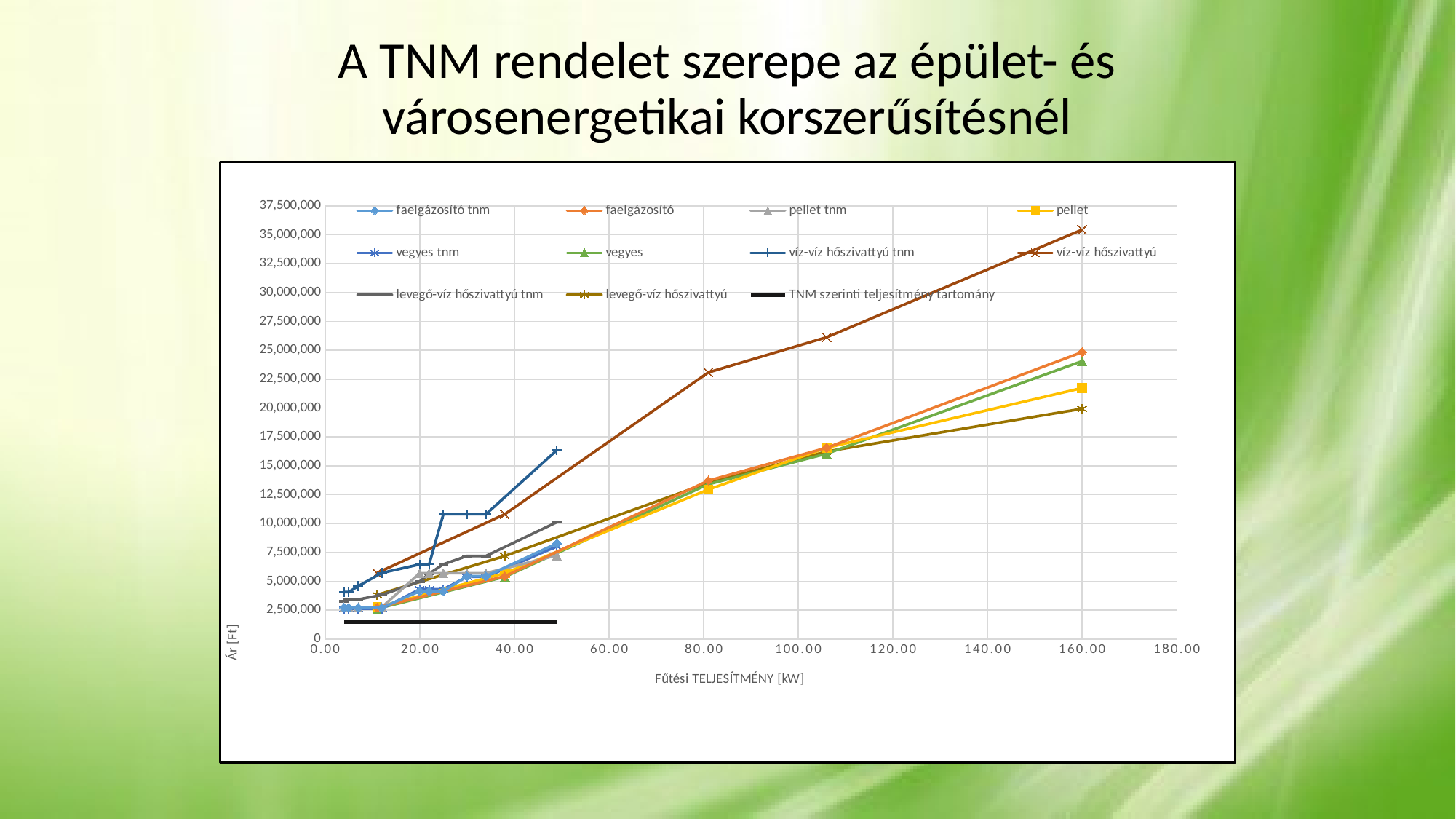
What kind of chart is shown on the slide? line chart Is the value for víz-víz hőszivattyú at 160.00 kW greater or less than 30,000,000? greater What is the title of the x axis of the chart? Fűtési TELJESÍTMÉNY [kW] Is the value for levegő-víz hőszivattyú at 160.00 kW greater or less than 22,500,000? less At 160.00 kW, which is larger: the value for víz-víz hőszivattyú or the value for pellet? víz-víz hőszivattyú Which series has the lowest value at 160.00 kW? levegő-víz hőszivattyú What is the title of the y axis of the chart? Ár [Ft] Is the value for víz-víz hőszivattyú tnm at its last point (around 49 kW) greater or less than 15,000,000? greater How many series does the chart legend list? 11 Do the values for faelgázosító rise or fall as the heating capacity increases along the x axis? rise Which series reaches the highest value at 160.00 kW? víz-víz hőszivattyú